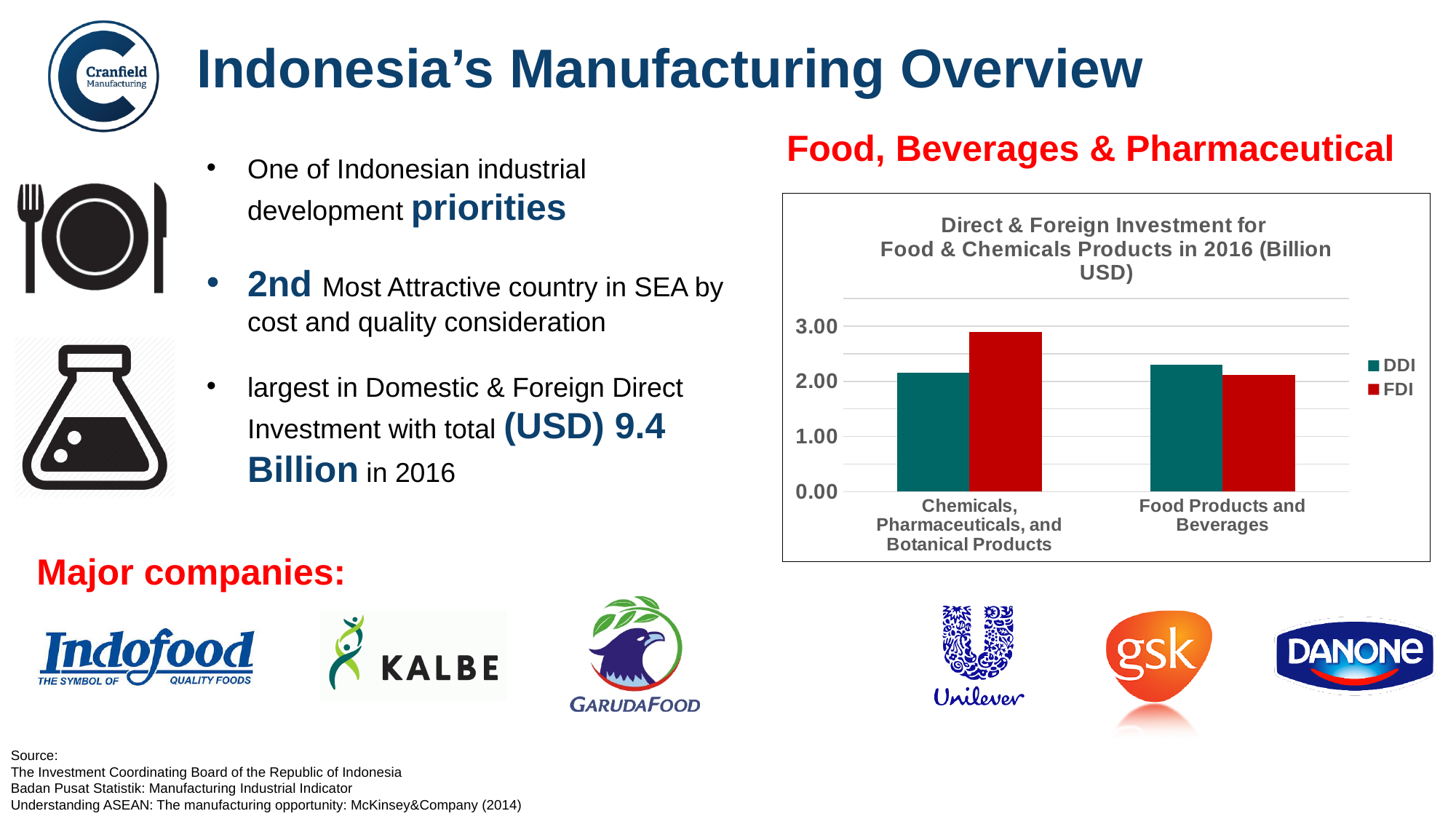
What kind of chart is shown on the slide? Bar chart For Chemicals, Pharmaceuticals, and Botanical Products, which is larger, DDI or FDI? FDI Is the DDI value for Food Products and Beverages greater or less than 2.00? greater How many categories are shown on the x axis of the chart? 2 Is the DDI value for Chemicals, Pharmaceuticals, and Botanical Products greater or less than 3.00? less Is the FDI value for Chemicals, Pharmaceuticals, and Botanical Products greater or less than 3.00? less Which bar in the chart is the tallest overall? FDI for Chemicals, Pharmaceuticals, and Botanical Products What is the title of the chart? Direct & Foreign Investment for Food & Chemicals Products in 2016 (Billion USD) Which category has the higher FDI value? Chemicals, Pharmaceuticals, and Botanical Products How many series does the chart's legend list? 2 Which series is shown in red in the chart? FDI